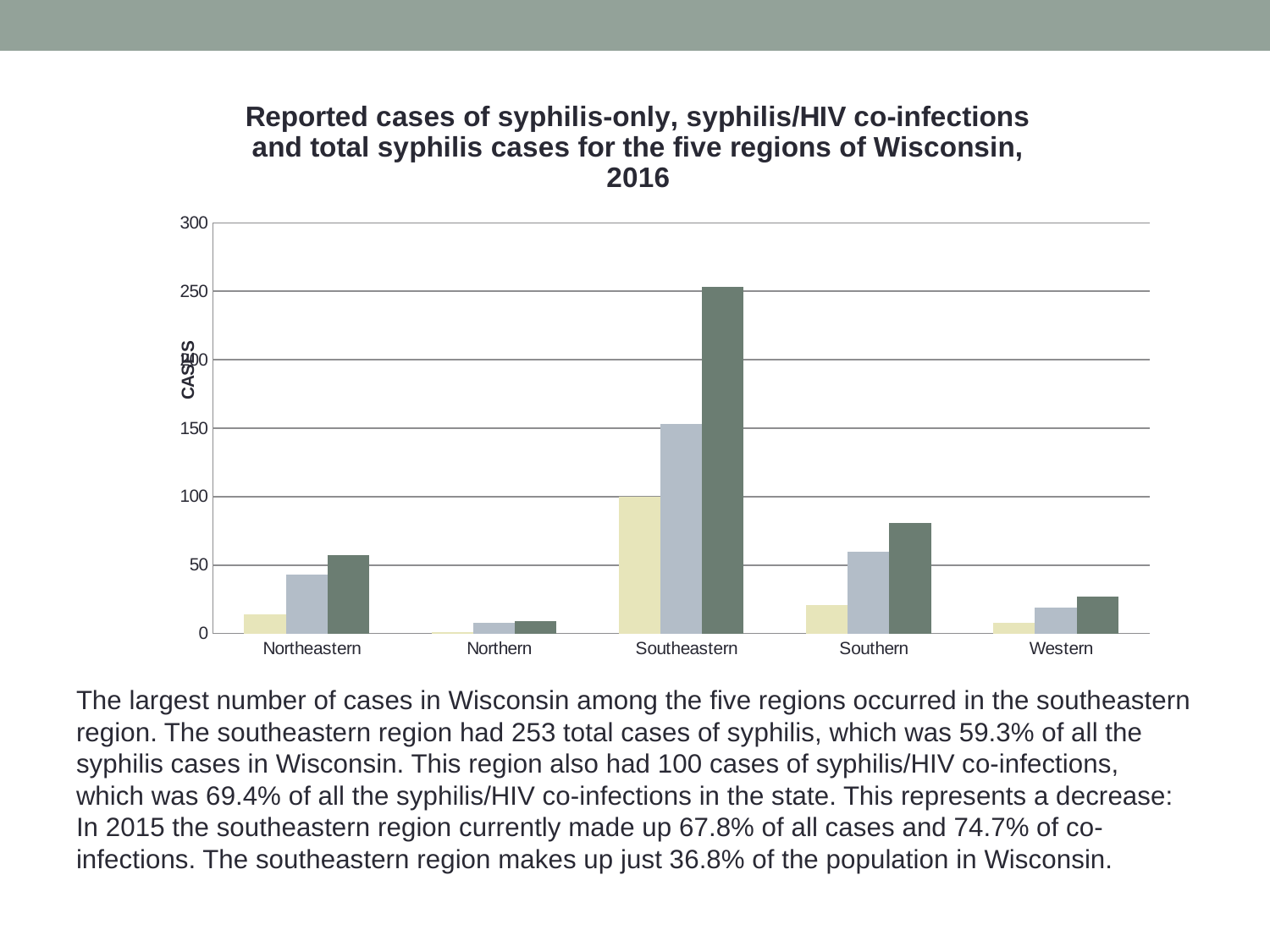
What is the label on the y axis of the chart? CASES Is the dark green bar for Southeastern greater or less than 200? greater Which region has the tallest dark green bar in the chart? Southeastern Is the dark green bar for Northeastern greater or less than 50? greater How many bars are plotted for each region in the chart? 3 Is the light blue-gray bar for Southeastern greater or less than 100? greater What kind of chart is shown on the slide? bar chart What value does the light yellow bar for Southeastern reach on the y axis? 100 How many regions are shown along the x axis of the chart? 5 Which region has the shortest dark green bar in the chart? Northern Which region has the larger dark green bar, Southern or Western? Southern